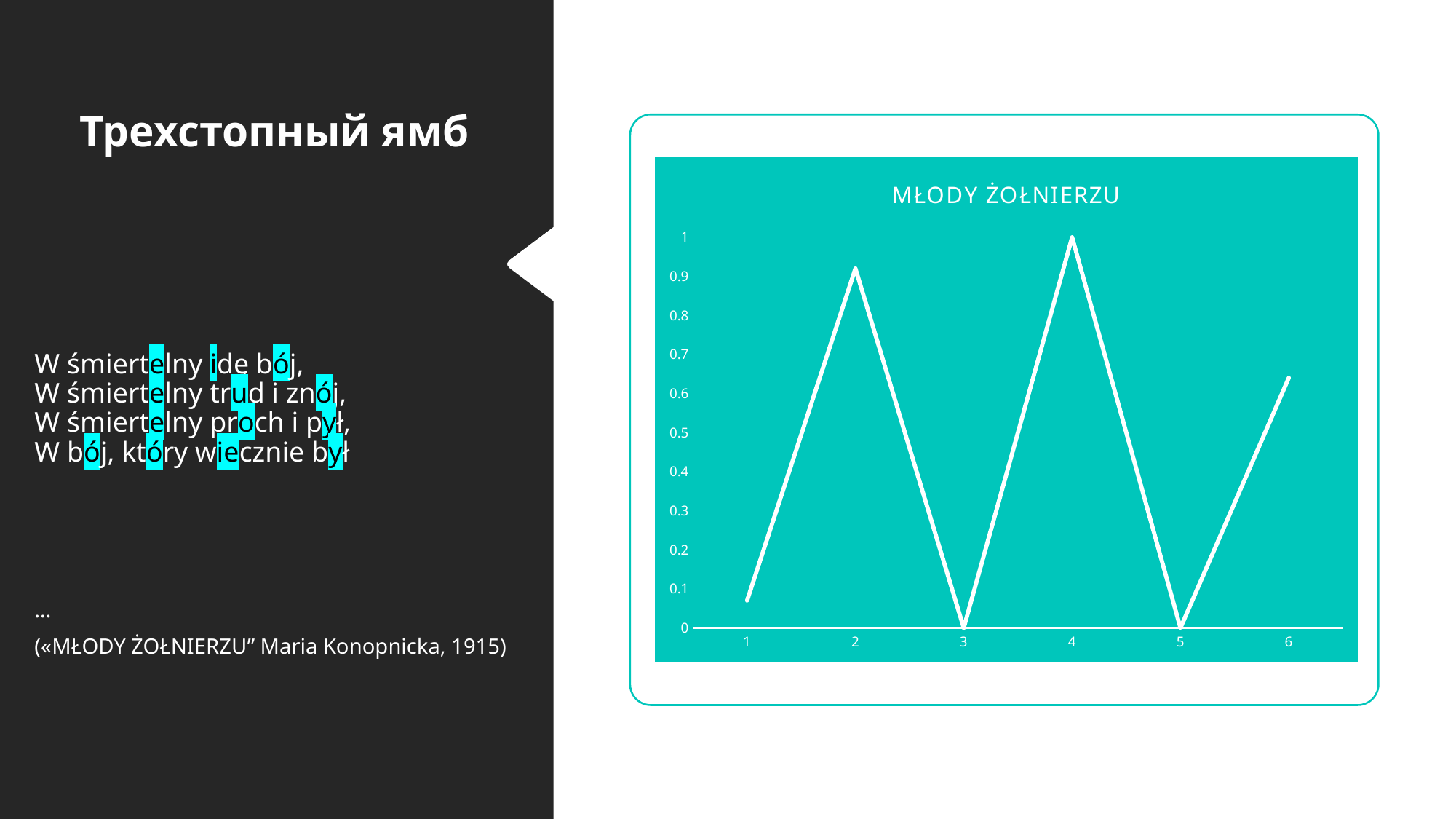
What is the value at point 4? 1 Is the value at point 6 greater or less than 0.5? greater What is the difference between the values at point 4 and point 3? 1 What kind of chart is shown on the slide? line chart What is the title of the chart? MŁODY ŻOŁNIERZU Is the value at point 2 greater or less than 0.8? greater Is the value at point 1 greater or less than 0.2? less What is the value at point 5? 0 What is the value at point 3? 0 Which is larger, the value at point 2 or the value at point 6? point 2 How many points are plotted on the chart? 6 Which point on the x axis has the highest value? 4